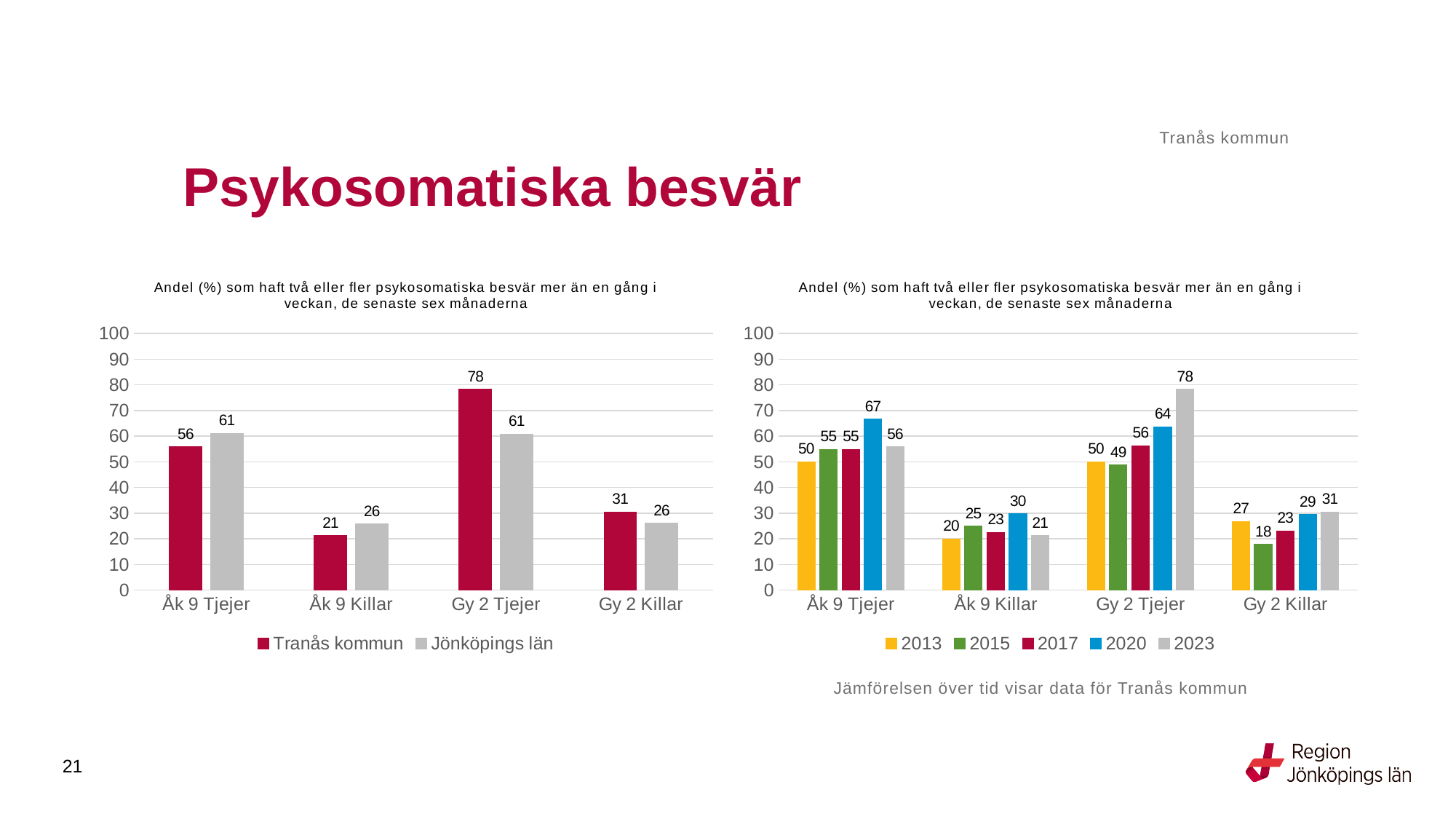
In the left chart, what is the value for Tranås kommun for Gy 2 Tjejer? 78 In the left chart, which is larger for Åk 9 Tjejer: Tranås kommun or Jönköpings län? Jönköpings län In the right chart, what is the value for 2020 for Åk 9 Tjejer? 67 What kind of chart is the right chart? Bar chart In the left chart, what is the difference between Tranås kommun and Jönköpings län for Gy 2 Tjejer? 17 In the left chart, how many series does the legend list? 2 In the right chart, which year has the highest value for Gy 2 Tjejer? 2023 In the left chart, what is the value for Jönköpings län for Åk 9 Killar? 26 In the right chart, what is the value for 2015 for Gy 2 Killar? 18 In the right chart, what is the difference between the 2013 and 2023 values for Gy 2 Tjejer? 28 In the left chart, which category has the lowest value for Tranås kommun? Åk 9 Killar In the right chart, how many series does the legend list? 5